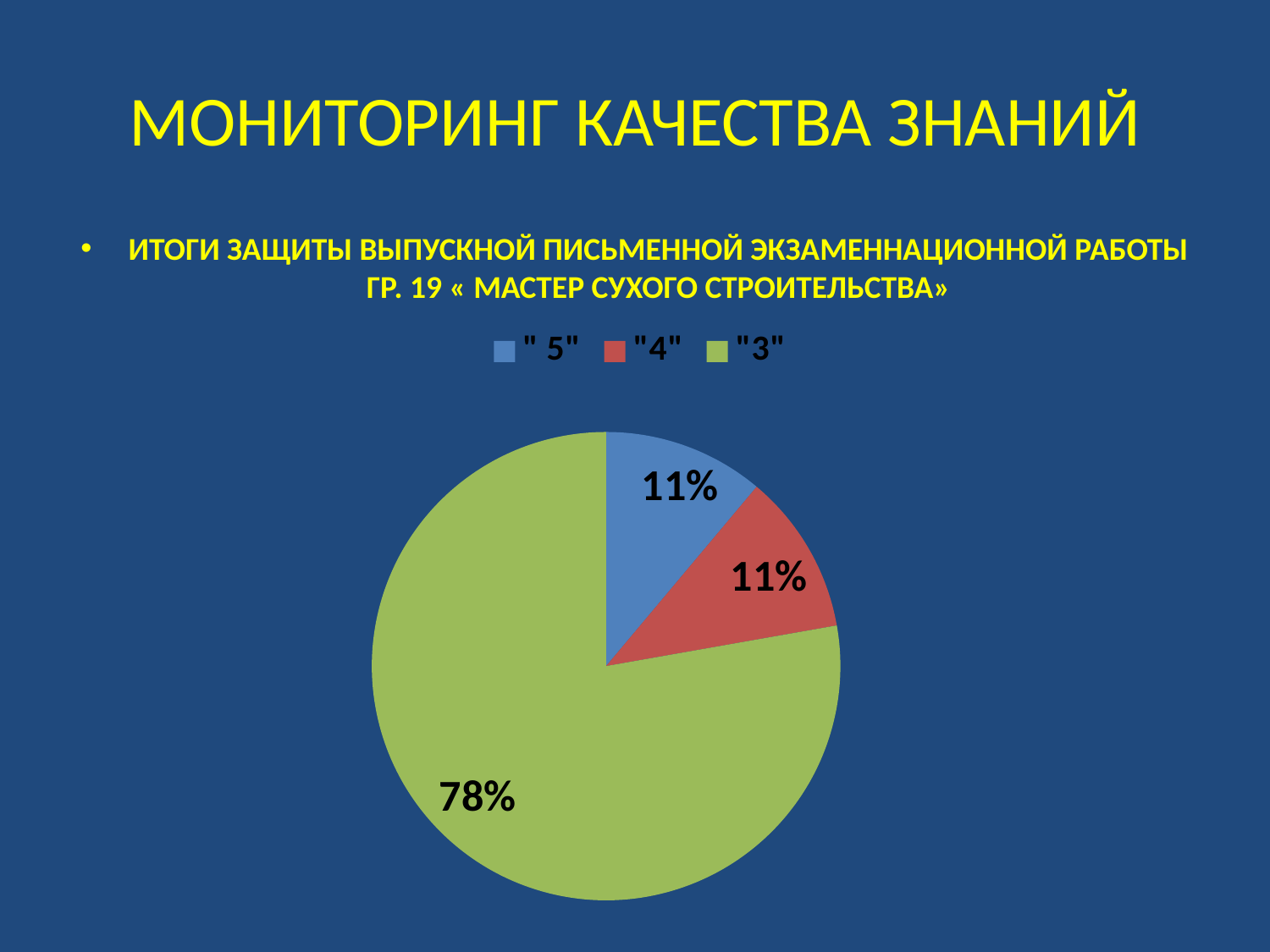
Is the share for "3" greater or less than 50%? greater How many entries does the legend list? 3 What share of the pie does the "4" slice represent? 11% What kind of chart is shown on the slide? pie chart How many slices does the pie chart have? 3 Which grade has the largest slice of the pie? "3" Which is larger, the share for "3" or the share for "4"? "3" What is the difference between the share for "3" and the share for "5"? 67% What share of the pie does the "3" slice represent? 78% What share of the pie does the "5" slice represent? 11% What colour is the slice for "3"? green What colour is the slice for "5"? blue